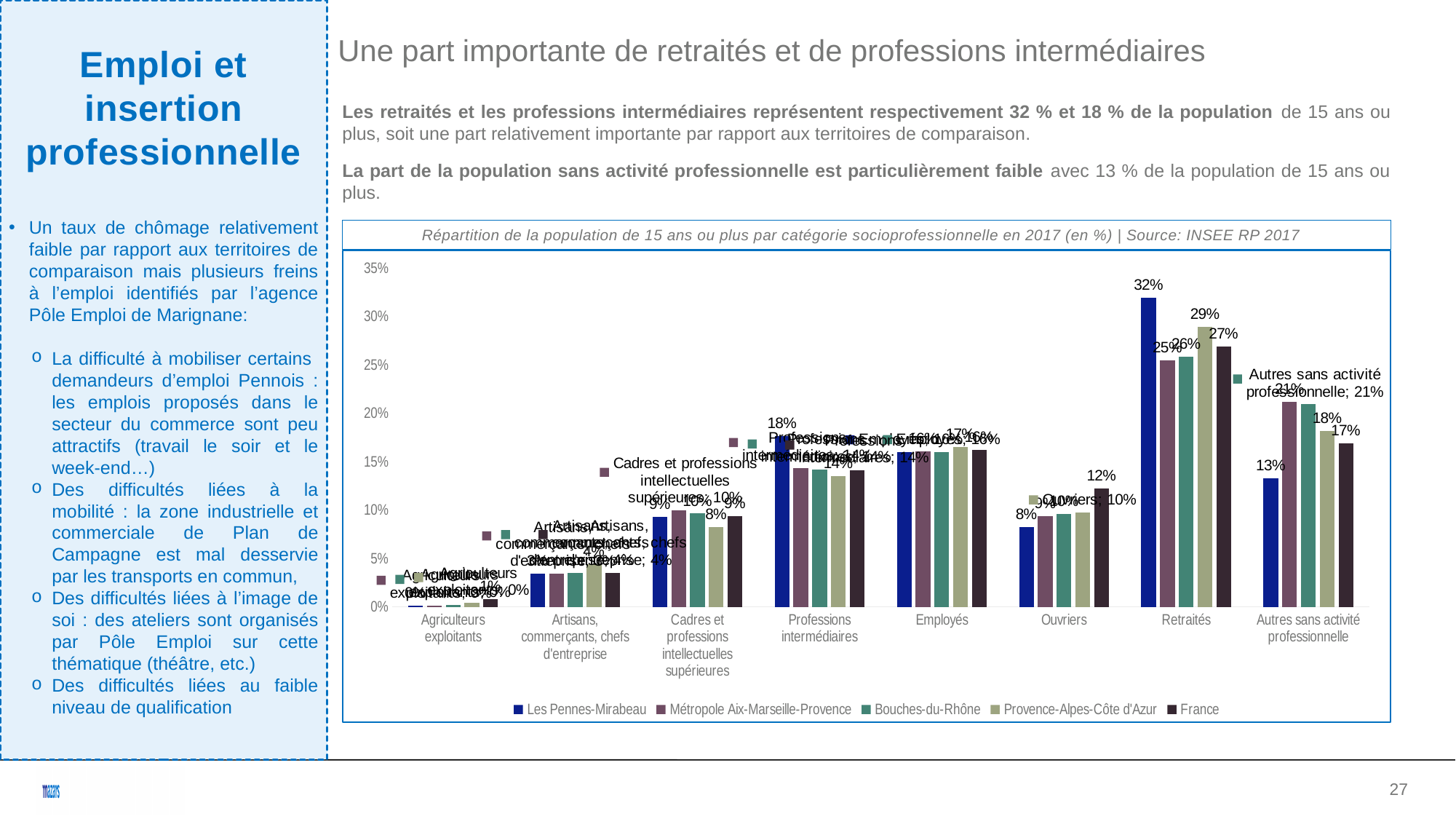
What is the value for France in the Ouvriers category? 12% What is the value for Les Pennes-Mirabeau in the Professions intermédiaires category? 18% How many series does the legend list? 5 What is the difference between Les Pennes-Mirabeau and Métropole Aix-Marseille-Provence in the Retraités category? 7 percentage points In the Retraités category, which is larger: Les Pennes-Mirabeau or France? Les Pennes-Mirabeau How many socioprofessional categories are shown on the x axis? 8 What is the value for Les Pennes-Mirabeau in the Autres sans activité professionnelle category? 13% What is the value for Provence-Alpes-Côte d'Azur in the Retraités category? 29% Is the value for Les Pennes-Mirabeau in the Ouvriers category greater or less than 10%? less What kind of chart is shown on the slide? Bar chart What is the value for Les Pennes-Mirabeau in the Retraités category? 32% Which category has the highest value for Les Pennes-Mirabeau? Retraités